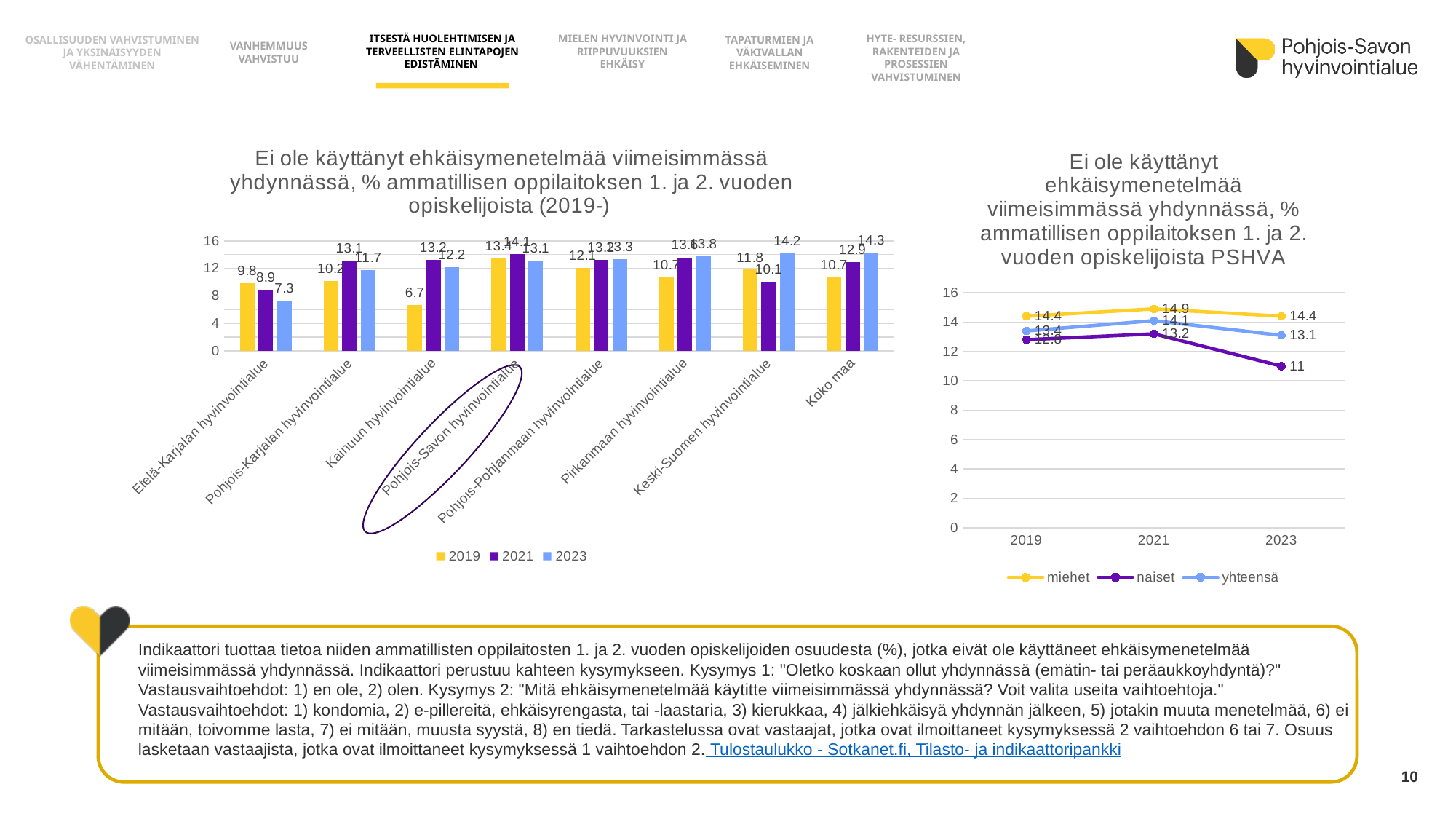
In the right line chart, what is the value for naiset in 2023? 11 In the left bar chart, what is the 2019 value for Kainuun hyvinvointialue? 6.7 In the left bar chart, which is larger for Pohjois-Karjalan hyvinvointialue: the 2019 value or the 2021 value? 2021 In the left bar chart, which category has the lowest 2023 value? Etelä-Karjalan hyvinvointialue How many categories are shown on the x axis of the left bar chart? 8 In the right line chart, which series has the highest value in 2021? miehet In the left bar chart, what is the 2021 value for Pohjois-Savon hyvinvointialue? 14.1 In the left bar chart, what is the 2023 value for Koko maa? 14.3 In the right line chart, does the naiset series rise or fall from 2021 to 2023? Fall How many series does the legend of the left bar chart list? 3 What kind of chart is the chart on the right of the slide? Line chart In the left bar chart, what is the difference between the 2023 and 2021 values for Keski-Suomen hyvinvointialue? 4.1